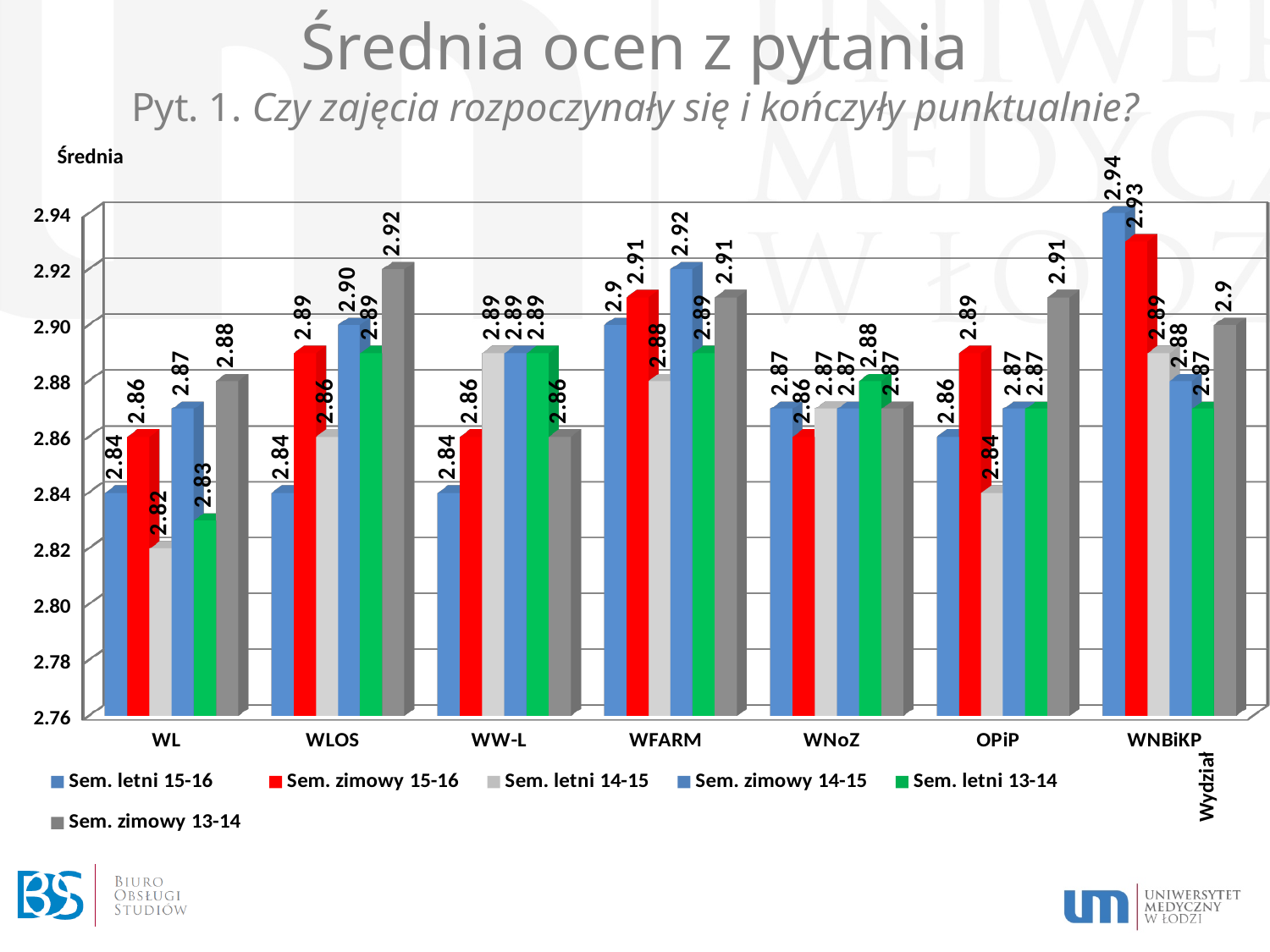
In the Sem. letni 13-14 series, which is larger: the value for WL or the value for WLOS? WLOS What is the label of the vertical axis? Średnia What is the value for WNoZ in the Sem. letni 13-14 series? 2.88 Which faculty has the highest value in the Sem. zimowy 15-16 series? WNBiKP What is the value for WNBiKP in the Sem. zimowy 15-16 series? 2.93 What is the value for WLOS in the Sem. zimowy 13-14 series? 2.92 Which faculty has the lowest value in the Sem. letni 14-15 series? WL What kind of chart is shown on the slide? bar chart What is the value for OPiP in the Sem. letni 14-15 series? 2.84 How many faculties (categories) are shown on the x axis? 7 How many series does the legend list? 6 For WNBiKP, what is the difference between the Sem. zimowy 15-16 value and the Sem. letni 13-14 value? 0.06